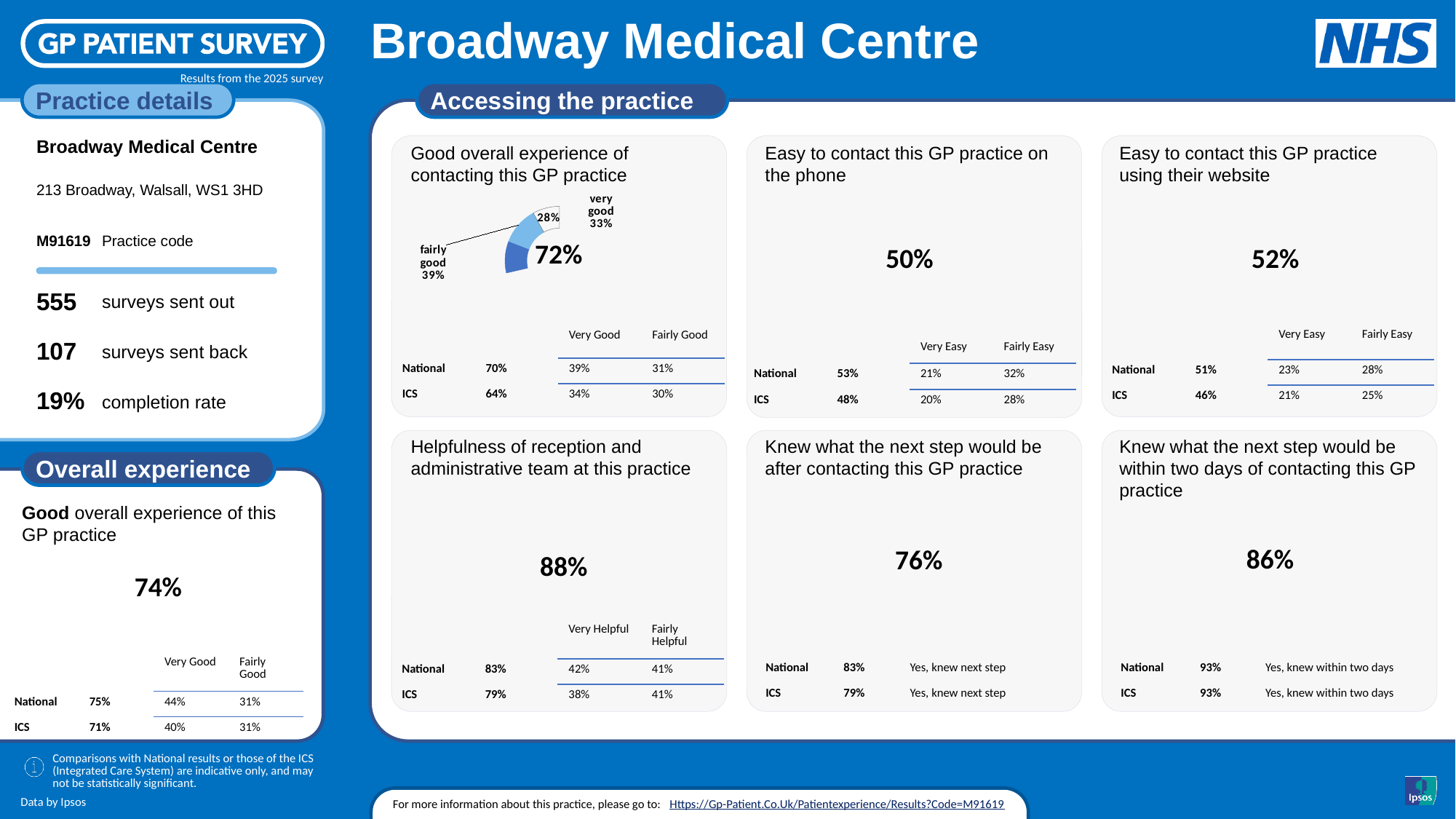
In the 'Good overall experience of contacting this GP practice' chart, which labelled slice has the largest value? fairly good How many slices with percentage labels are shown in the 'Good overall experience of contacting this GP practice' chart? 3 In the 'Good overall experience of contacting this GP practice' chart, what is the combined percentage of 'very good' and 'fairly good'? 72% In the 'Good overall experience of contacting this GP practice' chart, what percentage is shown on the slice without a category name? 28% What large percentage is printed in the centre of the 'Good overall experience of contacting this GP practice' chart? 72% In the 'Good overall experience of contacting this GP practice' chart, what is the difference between the 'fairly good' and 'very good' percentages? 6 percentage points What kind of chart is shown in the 'Good overall experience of contacting this GP practice' panel? pie chart In the 'Good overall experience of contacting this GP practice' chart, what percentage is labelled 'very good'? 33% Under which section heading does the 'Good overall experience of contacting this GP practice' chart appear? Accessing the practice In the 'Good overall experience of contacting this GP practice' chart, which is larger: 'fairly good' or 'very good'? fairly good In the 'Good overall experience of contacting this GP practice' chart, what percentage is labelled 'fairly good'? 39%